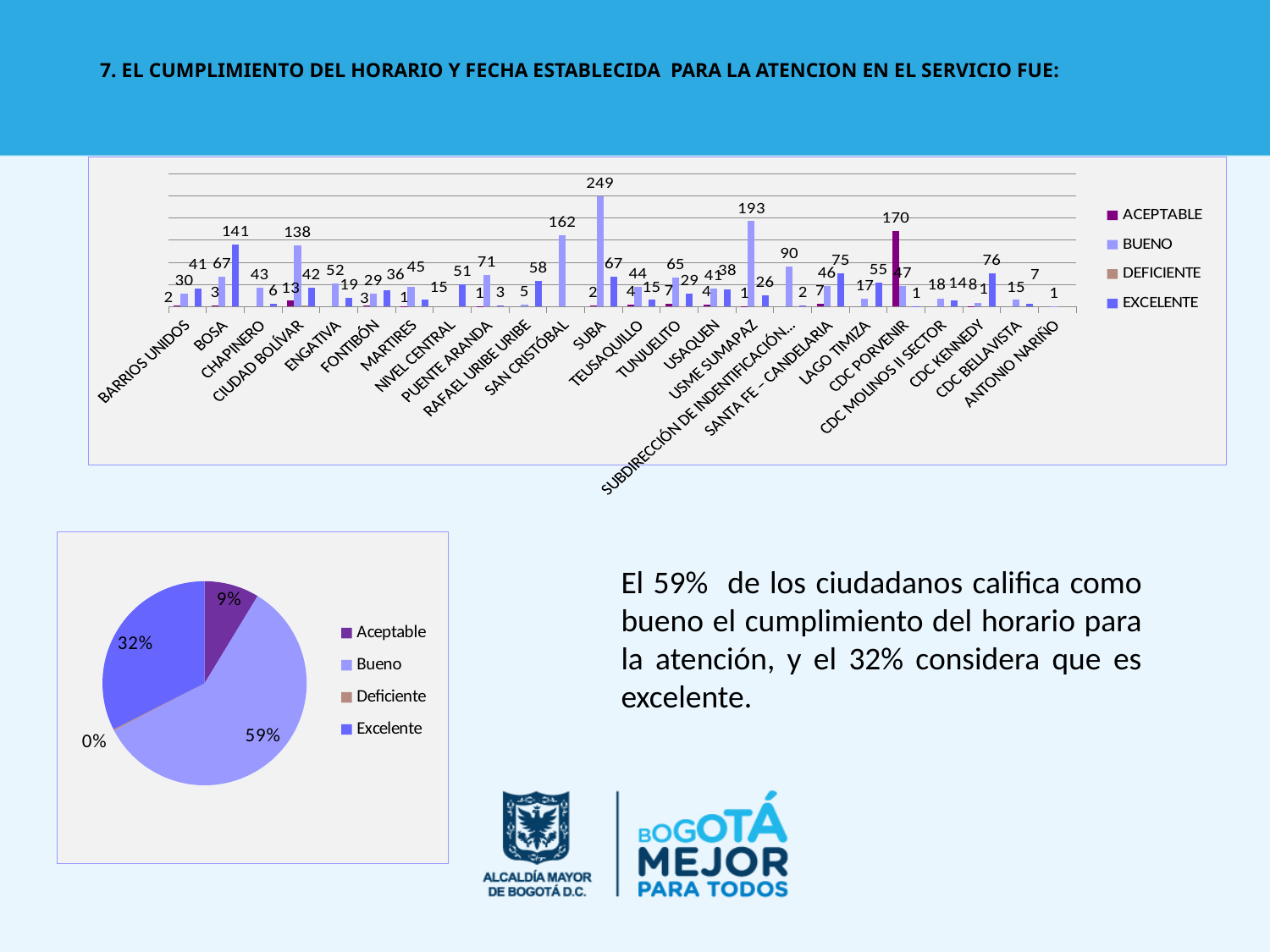
In the top bar chart, which category has the tallest bar? SUBA In the top bar chart, which is larger, the BUENO value for USME SUMAPAZ or the BUENO value for SAN CRISTÓBAL? USME SUMAPAZ What kind of chart is the top chart on the slide? Bar chart In the pie chart, which slice is larger, Aceptable or Excelente? Excelente In the pie chart, what percentage corresponds to Excelente? 32% In the pie chart, how many percentage points larger is the Bueno slice than the Excelente slice? 27 percentage points In the pie chart, what percentage of citizens rated the compliance as Bueno? 59% In the top bar chart, what is the BUENO value for SUBA? 249 How many categories does the legend of the pie chart list? 4 In the pie chart, which category has the smallest slice? Deficiente In the pie chart, what percentage corresponds to Aceptable? 9% In the pie chart, which category has the largest slice? Bueno